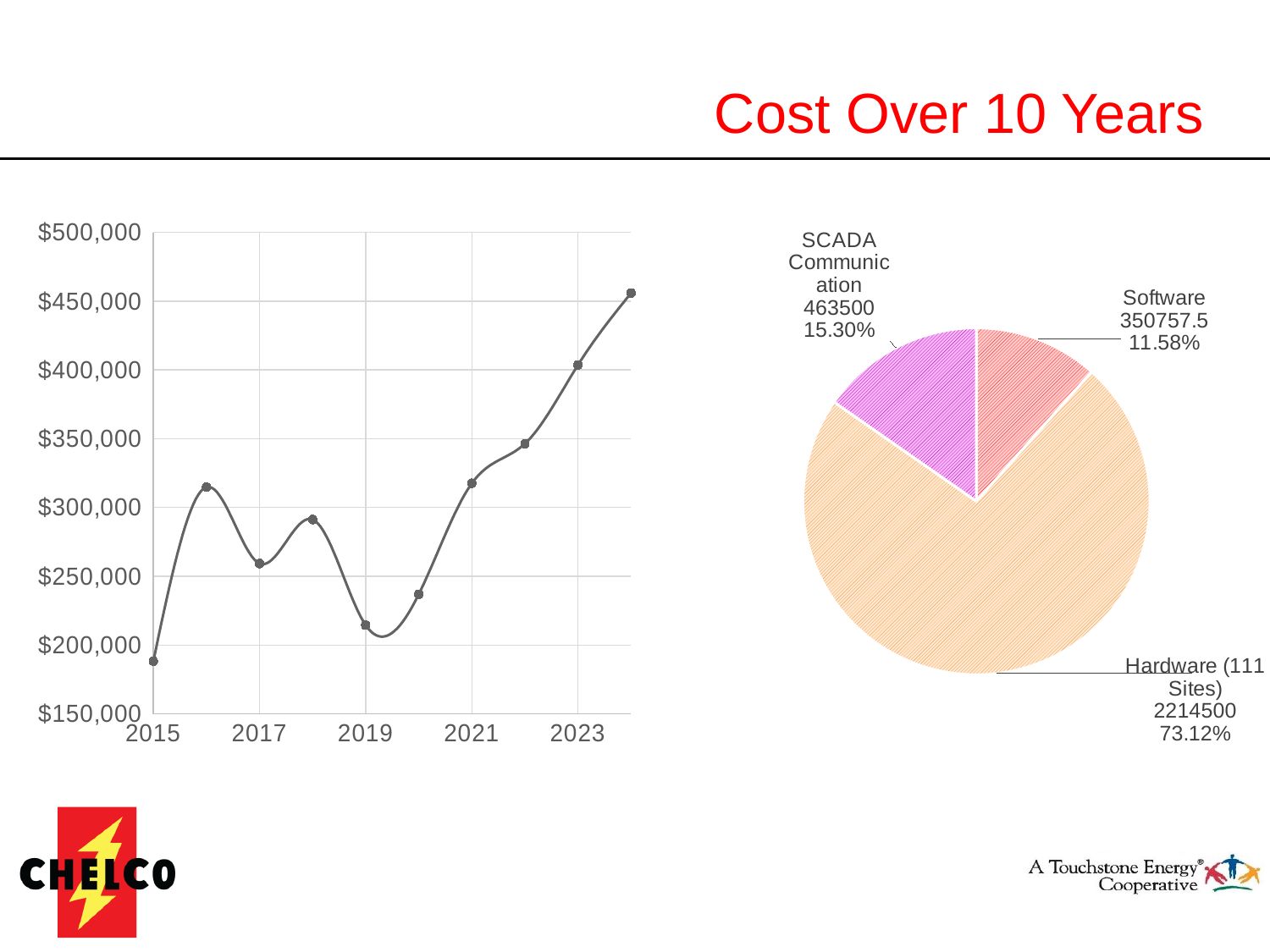
In the line chart on the left, is the value for 2019 greater or less than $250,000? less In the line chart on the left, which year has the lowest value? 2015 What kind of chart is the chart on the left of the slide? line chart In the pie chart on the right, what share does Hardware (111 Sites) have? 73.12% In the pie chart on the right, what is the value for SCADA Communication? 463500 In the line chart on the left, which is larger, the value for 2016 or the value for 2017? 2016 What kind of chart is the chart on the right of the slide? pie chart In the line chart on the left, which year has the highest value? 2024 In the line chart on the left, do the values rise or fall from 2019 to 2024? rise In the pie chart on the right, which category has the smallest slice? Software In the line chart on the left, how many data points are plotted? 10